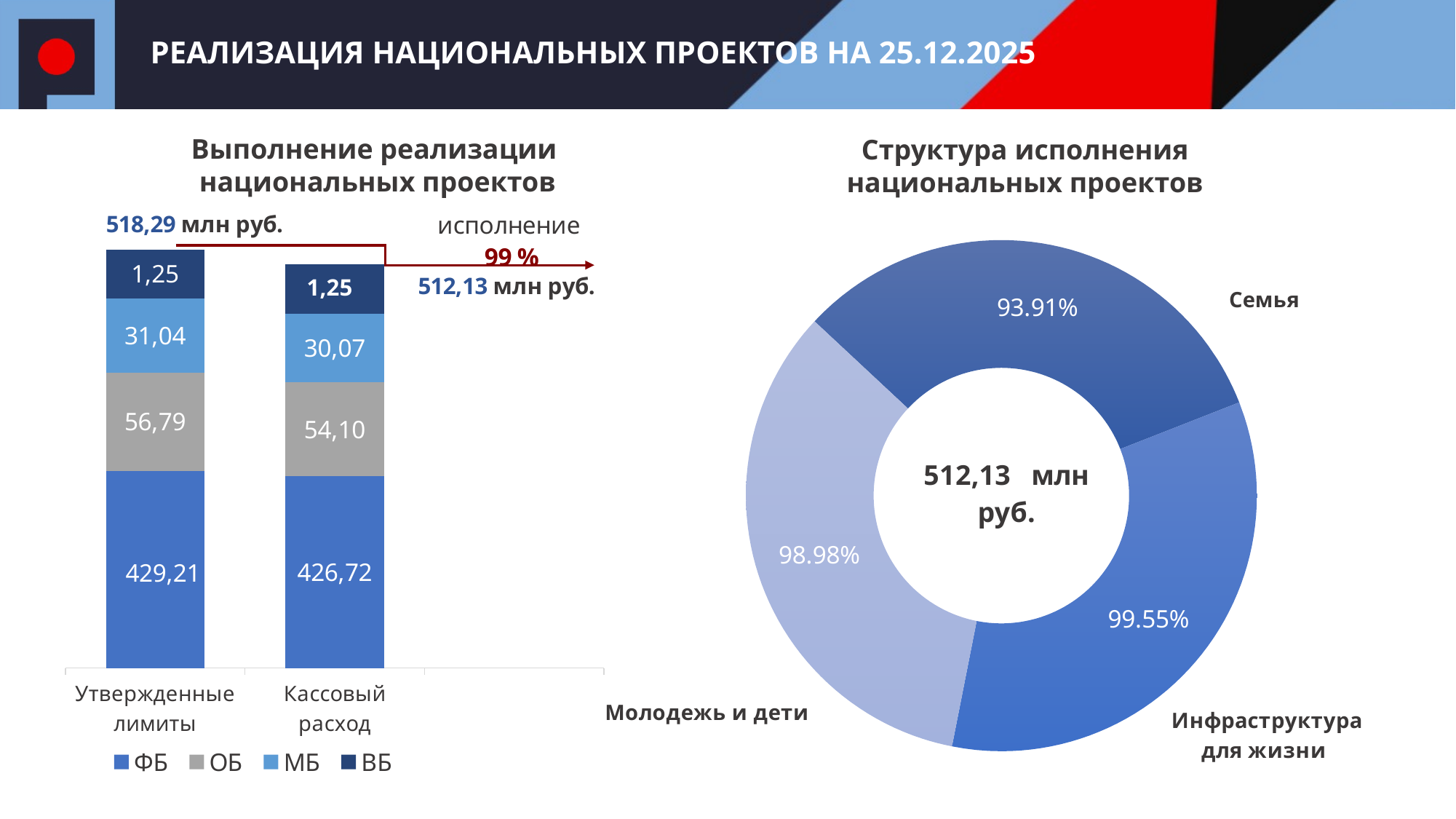
In the chart 'Выполнение реализации национальных проектов', what is the ФБ value for Утвержденные лимиты? 429,21 How many series does the legend of the chart 'Выполнение реализации национальных проектов' list? 4 In the chart 'Выполнение реализации национальных проектов', what is the МБ value for Утвержденные лимиты? 31,04 In the chart 'Выполнение реализации национальных проектов', what is the difference between the ФБ values for Утвержденные лимиты and Кассовый расход? 2,49 In the chart 'Структура исполнения национальных проектов', what percentage is shown for Семья? 93.91% In the chart 'Выполнение реализации национальных проектов', what is the ОБ value for Кассовый расход? 54,10 What value is shown in the centre of the chart 'Структура исполнения национальных проектов'? 512,13 млн руб. In the chart 'Выполнение реализации национальных проектов', which is larger: the МБ value for Утвержденные лимиты or for Кассовый расход? Утвержденные лимиты In the chart 'Выполнение реализации национальных проектов', what is the total shown for the Утвержденные лимиты bar? 518,29 млн руб. What kind of chart is 'Выполнение реализации национальных проектов'? Stacked bar chart In the chart 'Выполнение реализации национальных проектов', what is the total shown for the Кассовый расход bar? 512,13 млн руб. In the chart 'Структура исполнения национальных проектов', which category has the highest percentage label? Инфраструктура для жизни